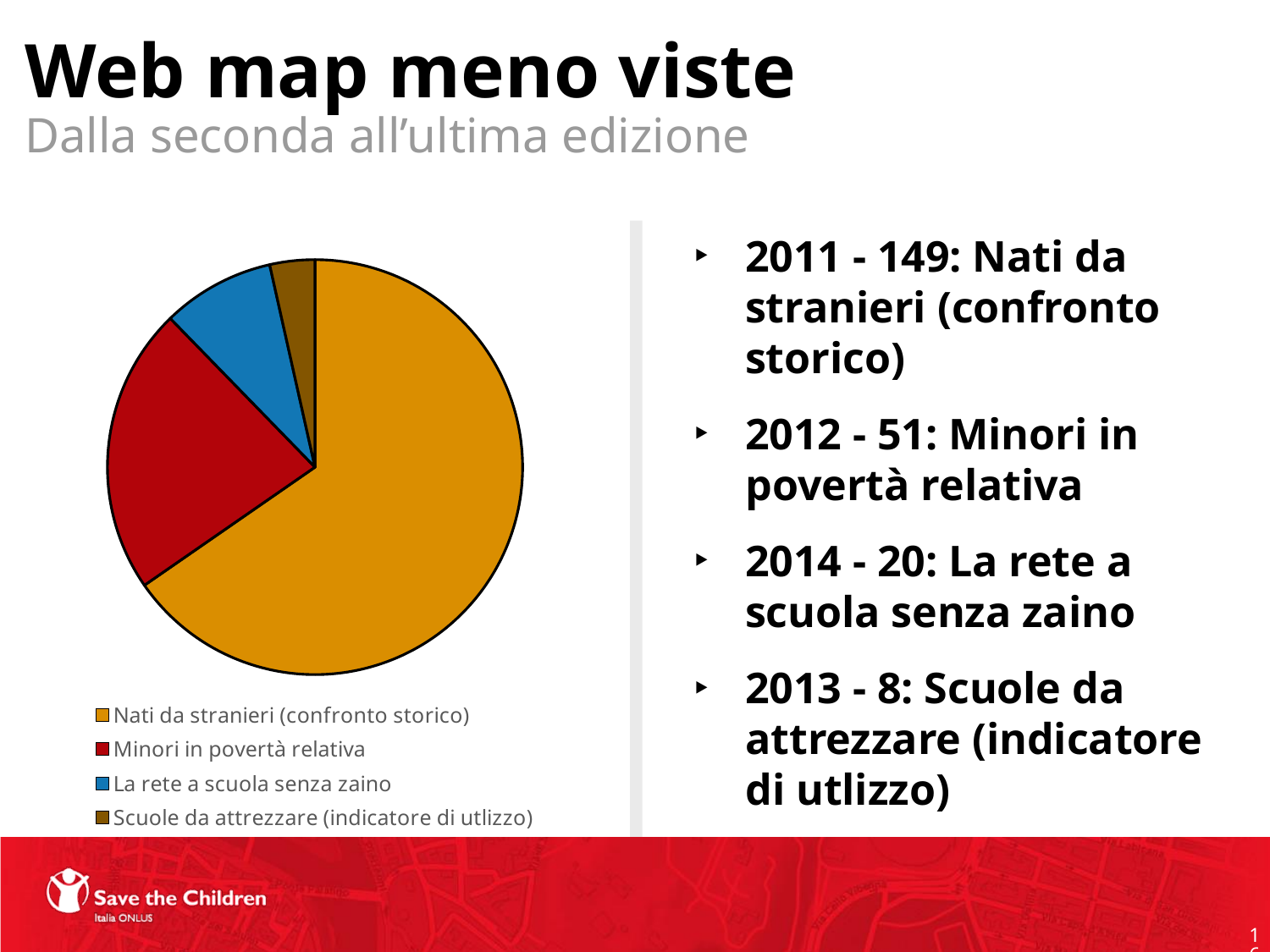
Which slice is larger: Minori in povertà relativa or La rete a scuola senza zaino? Minori in povertà relativa Which category has the largest slice of the pie chart? Nati da stranieri (confronto storico) What is the difference between the values for Nati da stranieri (confronto storico) and Minori in povertà relativa shown on the slide? 98 According to the slide, what is the value for Minori in povertà relativa? 51 Which category has the smallest slice of the pie chart? Scuole da attrezzare (indicatore di utlizzo) How many slices does the pie chart have? 4 According to the slide, what is the value for Nati da stranieri (confronto storico)? 149 Which slice is larger: La rete a scuola senza zaino or Scuole da attrezzare (indicatore di utlizzo)? La rete a scuola senza zaino How many entries does the legend of the pie chart list? 4 According to the slide, what is the value for Scuole da attrezzare (indicatore di utlizzo)? 8 What colour is the slice for La rete a scuola senza zaino in the pie chart? blue What kind of chart is shown on the slide? pie chart